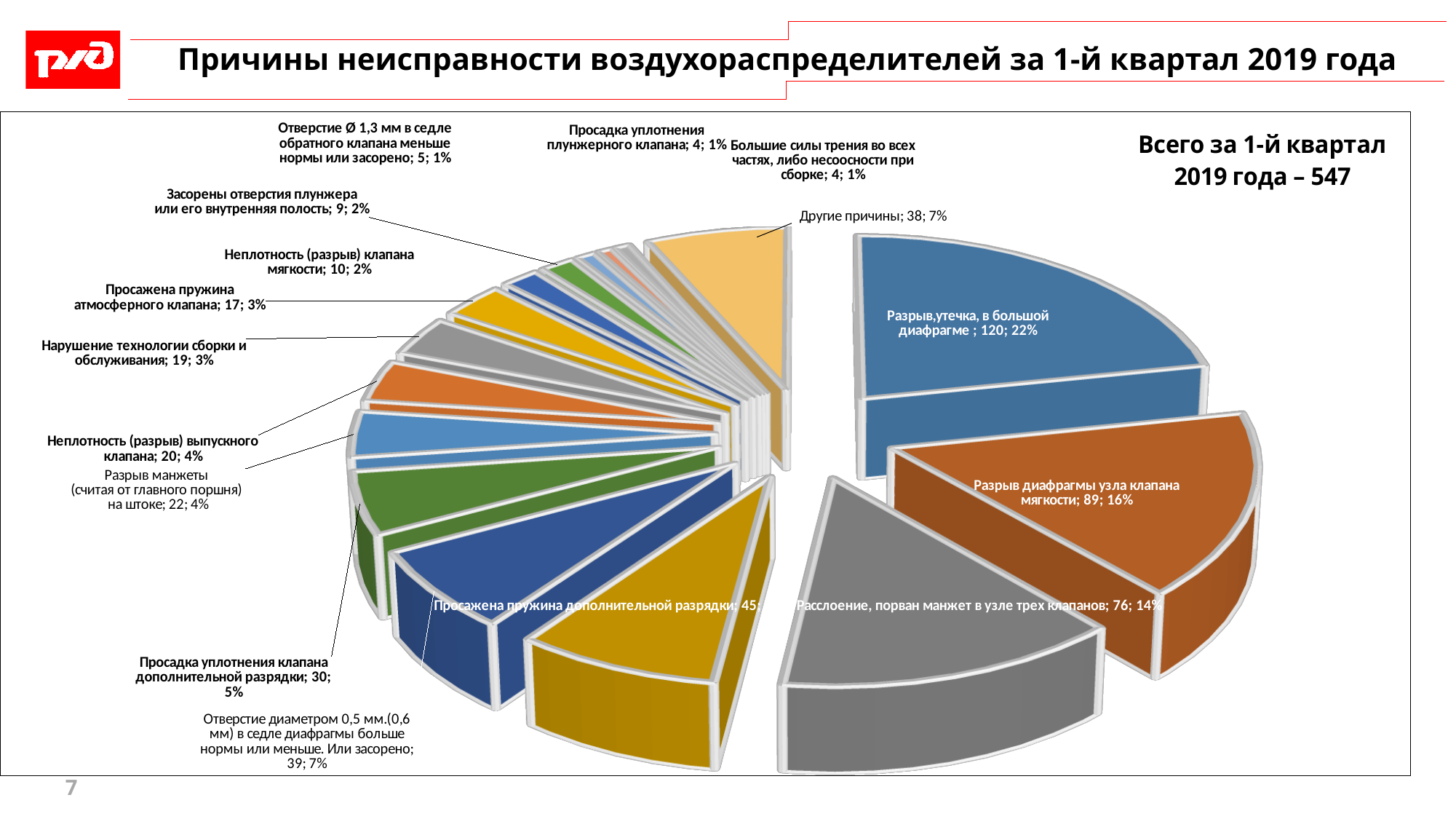
What percentage share does "Расслоение, порван манжет в узле трех клапанов" have? 14% How many cases are attributed to "Разрыв диафрагмы узла клапана мягкости"? 89 What is the difference in cases between "Разрыв,утечка, в большой диафрагме" and "Разрыв диафрагмы узла клапана мягкости"? 31 What is the total number of cases for the 1st quarter of 2019 stated on the slide? 547 What percentage share does "Просажена пружина атмосферного клапана" have? 3% How many categories (causes) are shown in the pie chart? 16 How many cases are attributed to "Другие причины"? 38 Which has more cases: "Неплотность (разрыв) выпускного клапана" or "Нарушение технологии сборки и обслуживания"? Неплотность (разрыв) выпускного клапана What kind of chart is shown on the slide? Pie chart What is the value for "Просадка уплотнения клапана дополнительной разрядки"? 30 What is the title of the slide? Причины неисправности воздухораспределителей за 1-й квартал 2019 года Which cause has the largest share of the pie? Разрыв,утечка, в большой диафрагме